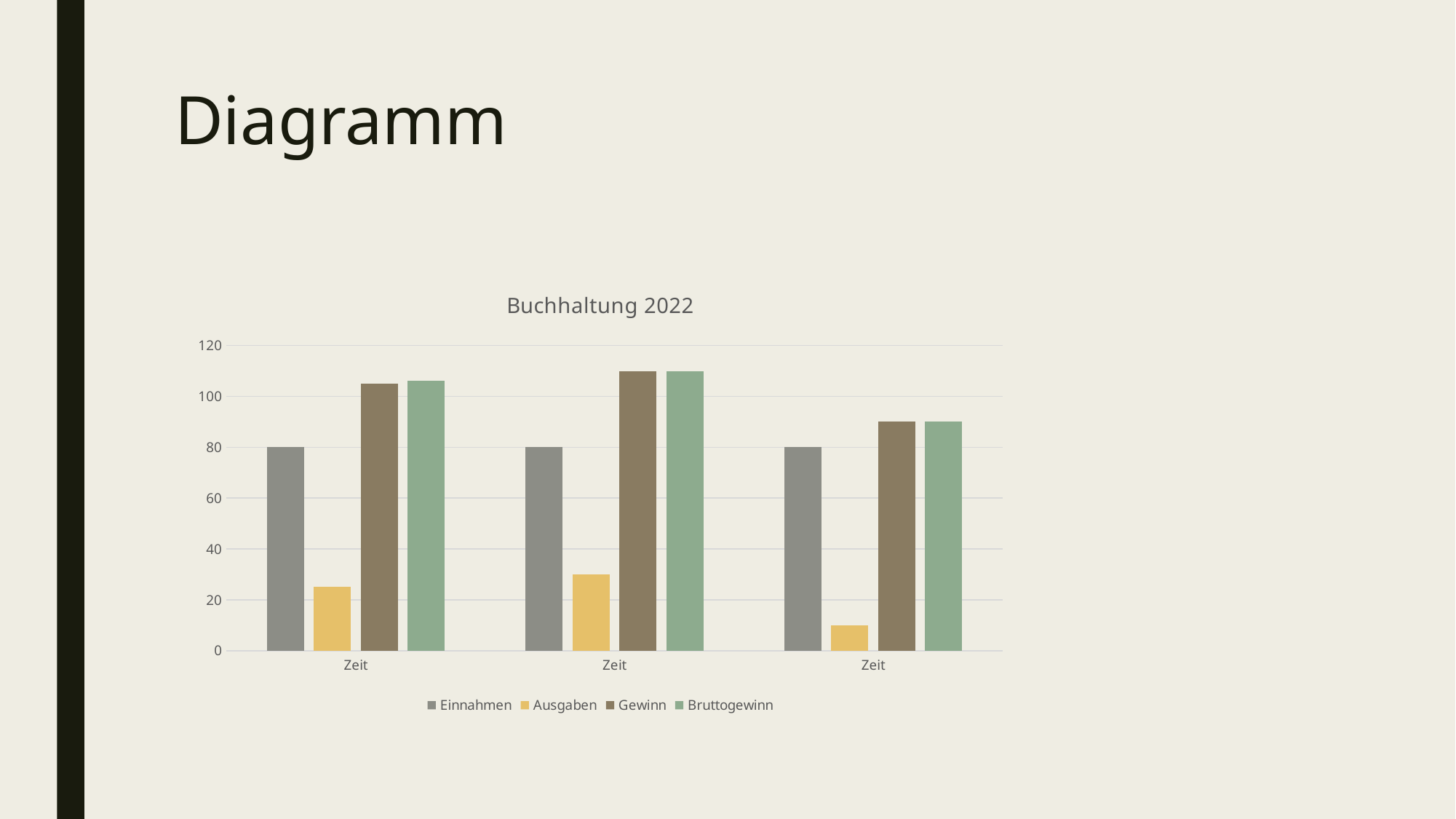
Which series is shown in yellow in the chart's legend? Ausgaben What is the value of Einnahmen in the third category group? 80 What is the value of Einnahmen in the first category group? 80 How many category groups are shown along the x axis of the chart? 3 Is the value for Gewinn in the second category group greater or less than 100? greater How many series does the chart's legend list? 4 What is the title of the chart? Buchhaltung 2022 In the first category group, which is larger: Einnahmen or Ausgaben? Einnahmen Is the value for Ausgaben in the third category group greater or less than 20? less Which series has the lowest value in the second category group? Ausgaben Is the value for Ausgaben in the first category group greater or less than 40? less What kind of chart is shown on the slide? bar chart